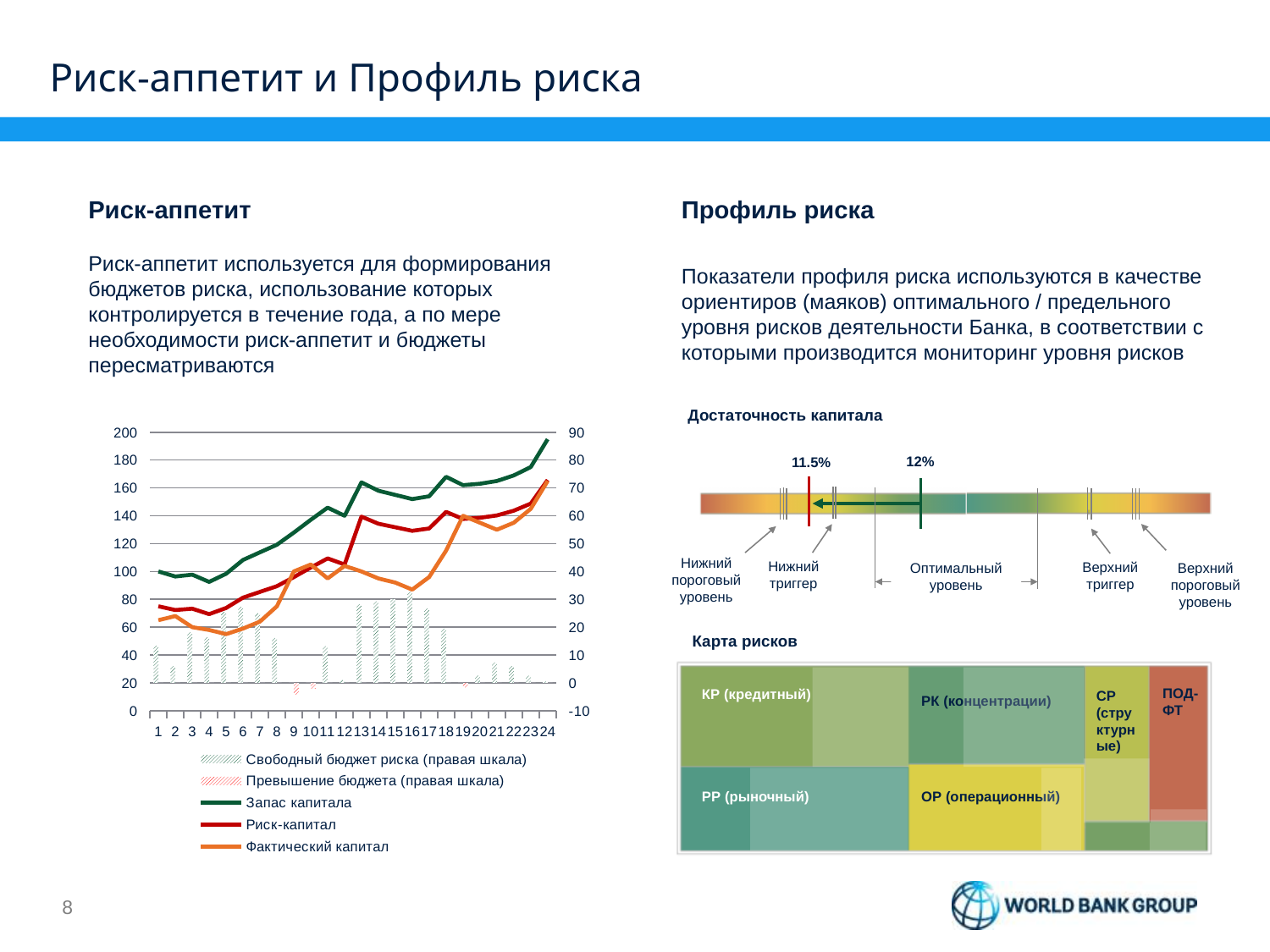
How many series does the legend of the chart on the left list? 5 In the chart on the left, is the value of 'Запас капитала' at point 13 greater or less than 140? greater In the chart on the left, at point 24, which is larger: 'Запас капитала' or 'Риск-капитал'? Запас капитала In the chart on the left, is the value of 'Фактический капитал' at point 4 greater or less than 80? less In the chart on the left, does the 'Запас капитала' line rise or fall overall from point 1 to point 24? Rises In the chart on the left, at point 1, which is larger: 'Риск-капитал' or 'Фактический капитал'? Риск-капитал In the chart on the left, which two legend entries are plotted on the right scale? Свободный бюджет риска and Превышение бюджета What kind of chart is shown on the left of the slide? A combined line and bar chart In the chart on the left, at which x-axis point is 'Запас капитала' highest? 24 In the chart on the left, is the value of 'Запас капитала' at point 24 greater or less than 180? greater How many points are shown along the x axis of the chart on the left? 24 What is the highest tick value on the right-hand axis of the chart on the left? 90